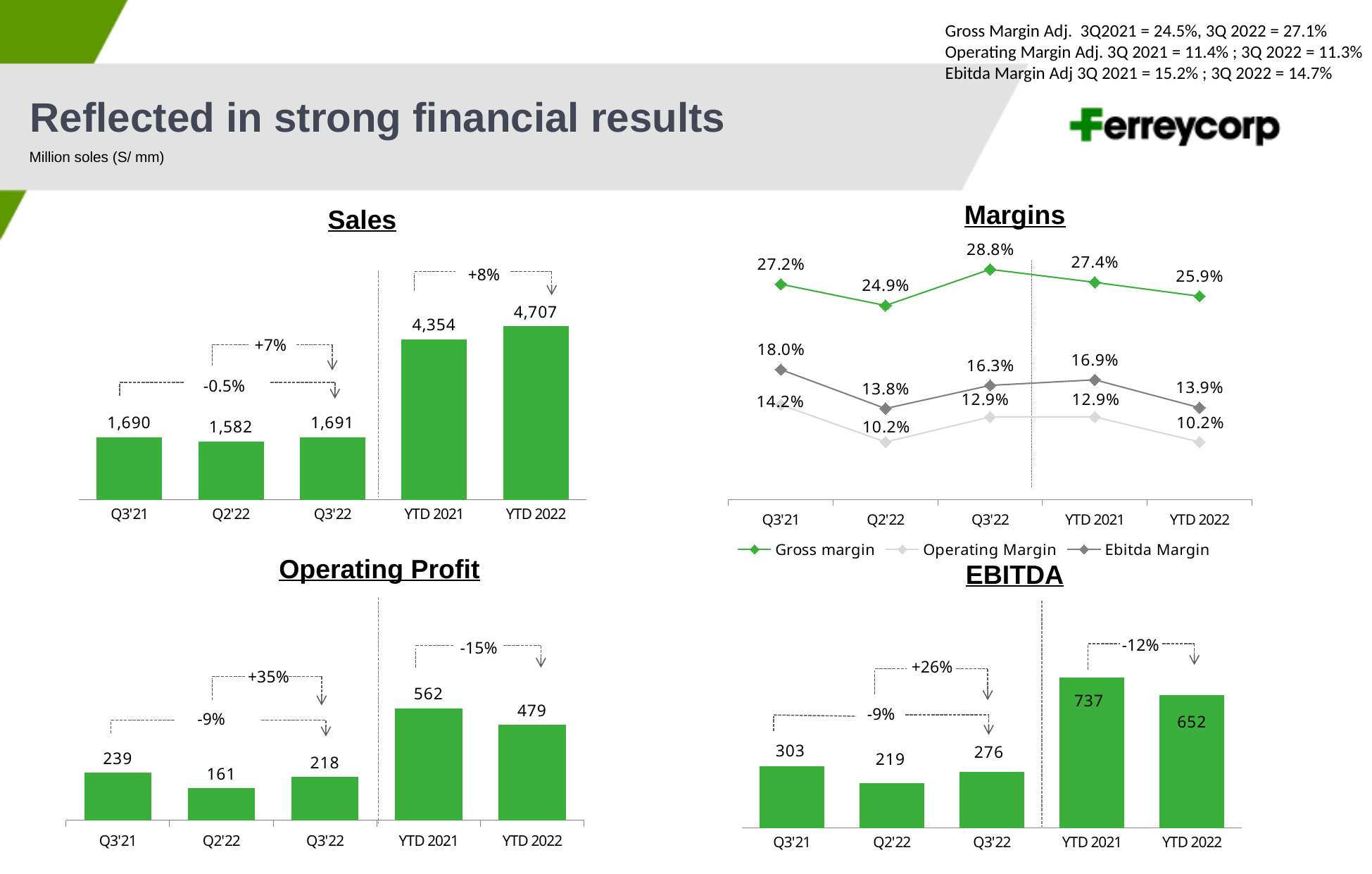
In the Sales chart, what is the difference between YTD 2022 and YTD 2021? 353 In the Sales chart, what is the value for YTD 2022? 4,707 In the EBITDA chart, how many categories are shown on the x axis? 5 In the Operating Profit chart, what is the value for Q3'22? 218 In the Operating Profit chart, what is the difference between YTD 2021 and YTD 2022? 83 In the Margins chart, how many series does the legend list? 3 In the Margins chart, which is larger: the Operating Margin for Q3'21 or for Q2'22? Q3'21 In the Margins chart, what is the Gross margin for Q3'22? 28.8% In the EBITDA chart, which category has the highest value? YTD 2021 What type of chart is the Margins chart? Line chart In the Margins chart, what is the Ebitda Margin for YTD 2021? 16.9% In the Sales chart, which category has the lowest value? Q2'22